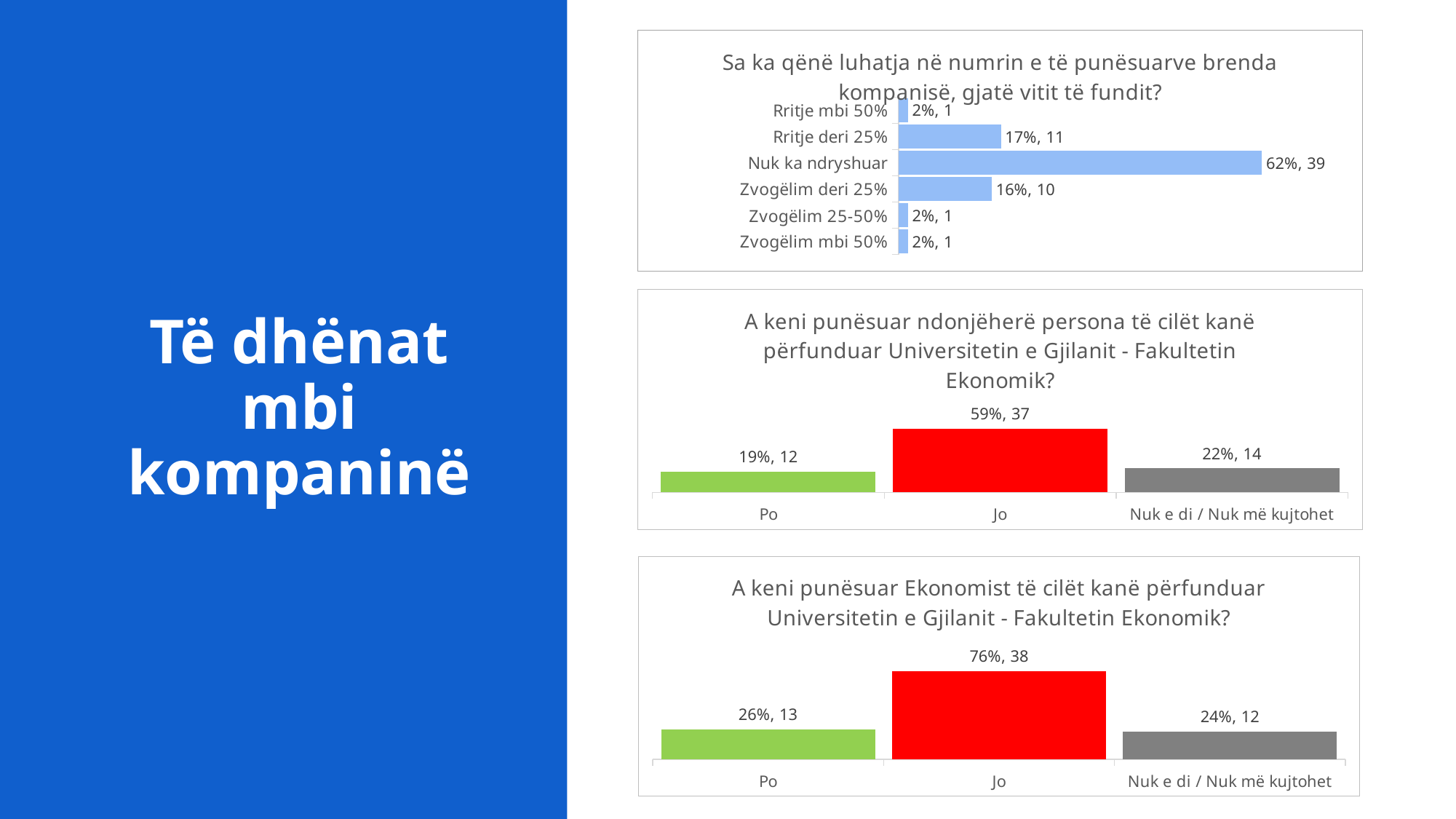
In the middle chart, which is larger, 'Po' or 'Nuk e di / Nuk më kujtohet'? Nuk e di / Nuk më kujtohet In the top chart, how many categories are shown? 6 In the middle chart, what is the data label for 'Jo'? 59%, 37 In the top chart, which category has the highest value? Nuk ka ndryshuar In the top chart, what is the data label for 'Rritje deri 25%'? 17%, 11 What type of chart is the top chart? Bar chart In the middle chart, which category has the lowest value? Po In the bottom chart, which category has the highest value? Jo In the top chart, what is the difference in count between 'Rritje deri 25%' and 'Zvogëlim deri 25%'? 1 In the top chart, what is the data label for 'Nuk ka ndryshuar'? 62%, 39 In the bottom chart, what is the data label for 'Po'? 26%, 13 In the bottom chart, what colour is the bar for 'Jo'? Red